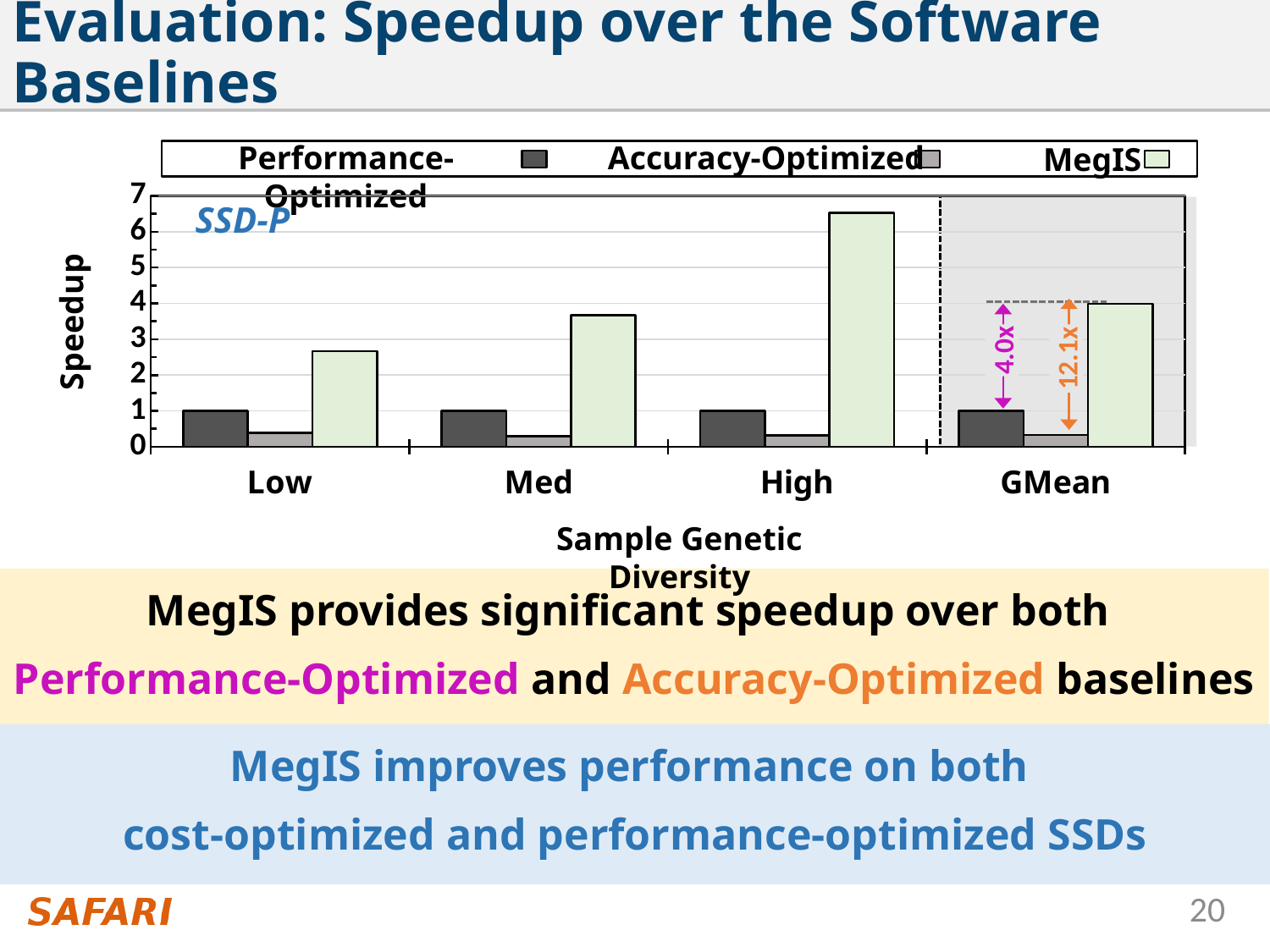
What is the speedup value of the Performance-Optimized bar for Low? 1 Which is larger for Med: the MegIS bar or the Accuracy-Optimized bar? MegIS How many categories are shown on the x axis? 4 What kind of chart is shown on the slide? bar chart Is the MegIS value for High greater or less than 6? greater For which category is the MegIS bar lowest? Low What is the label of the y axis? Speedup How many series does the legend list? 3 For which category is the MegIS bar highest? High What speedup does the annotation show for MegIS over Performance-Optimized at GMean? 4.0x Is the MegIS value for Low greater or less than 3? less What speedup does the annotation show for MegIS over Accuracy-Optimized at GMean? 12.1x